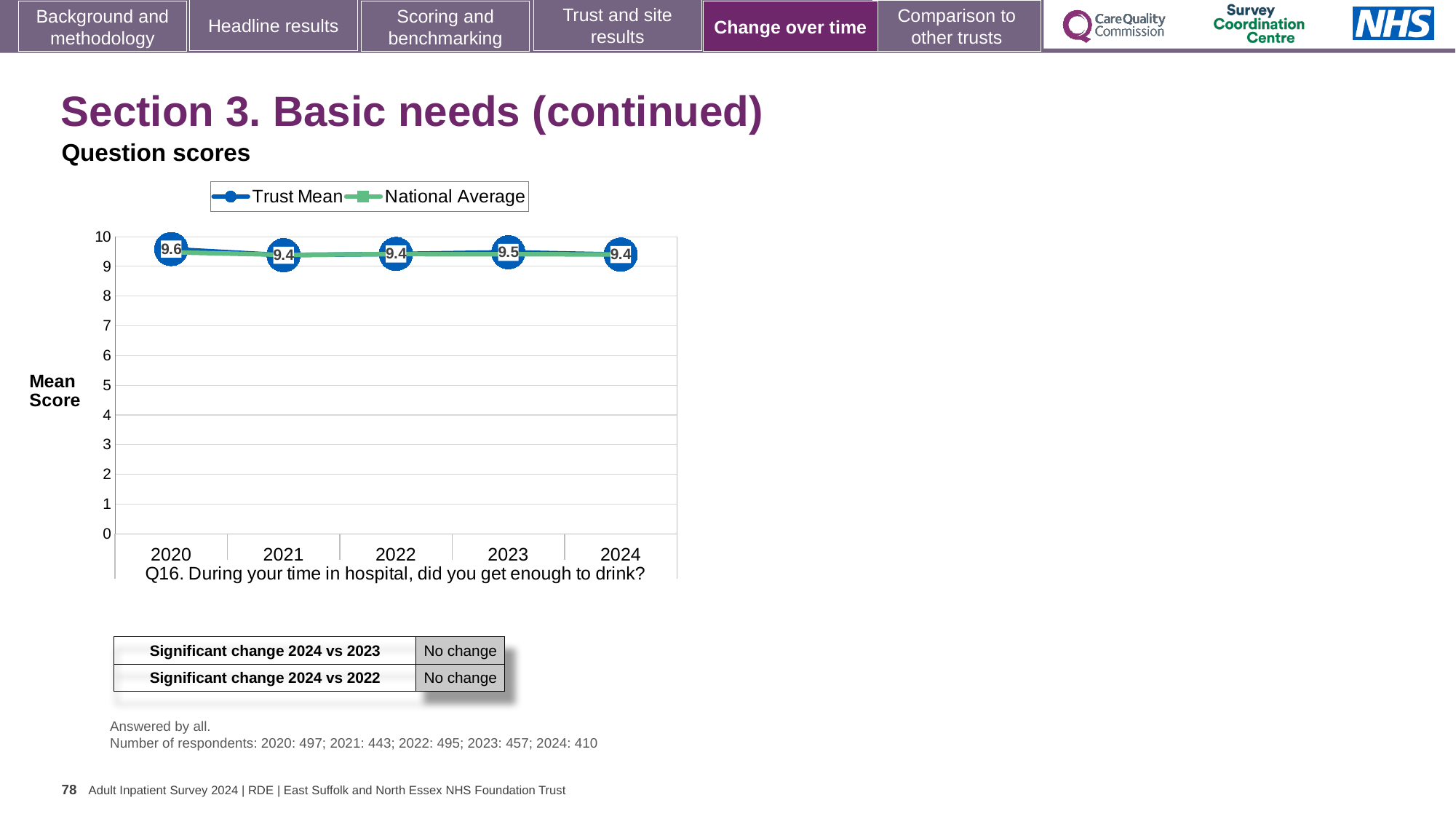
In which year is the Trust Mean score highest? 2020 How many years are shown on the x axis of the chart? 5 Which year has the larger Trust Mean score, 2020 or 2023? 2020 What kind of chart is shown on the slide? line chart Is the National Average value for 2022 greater or less than 9? greater How many series does the chart legend list? 2 What is the Trust Mean score for 2024? 9.4 What is the Trust Mean score for 2023? 9.5 What is the difference between the Trust Mean scores for 2020 and 2021? 0.2 Does the Trust Mean score rise or fall from 2020 to 2021? fall What is the Trust Mean score for 2020? 9.6 What question is the chart about, as shown below the x axis? Q16. During your time in hospital, did you get enough to drink?